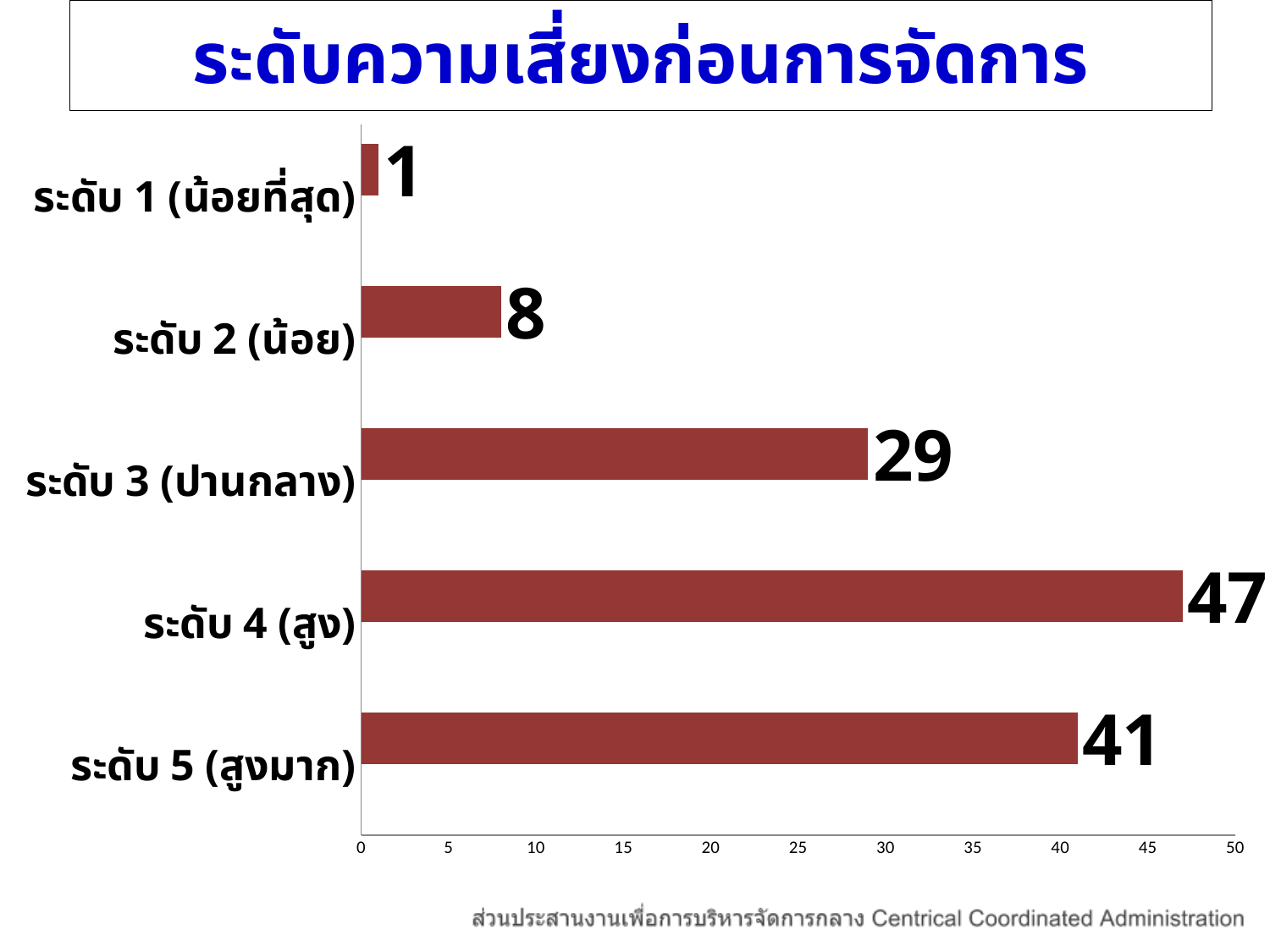
What is the value for ระดับ 1 (น้อยที่สุด)? 1 What is the difference between the values for ระดับ 4 (สูง) and ระดับ 5 (สูงมาก)? 6 How many categories are shown in the chart? 5 What kind of chart is shown on the slide? bar chart Which is larger, the value for ระดับ 2 (น้อย) or ระดับ 3 (ปานกลาง)? ระดับ 3 (ปานกลาง) What is the title of the chart? ระดับความเสี่ยงก่อนการจัดการ What is the value for ระดับ 5 (สูงมาก)? 41 Which category has the highest value? ระดับ 4 (สูง) Which category has the lowest value? ระดับ 1 (น้อยที่สุด) What is the value for ระดับ 3 (ปานกลาง)? 29 What is the value for ระดับ 4 (สูง)? 47 Is the value for ระดับ 5 (สูงมาก) greater or less than 40? greater